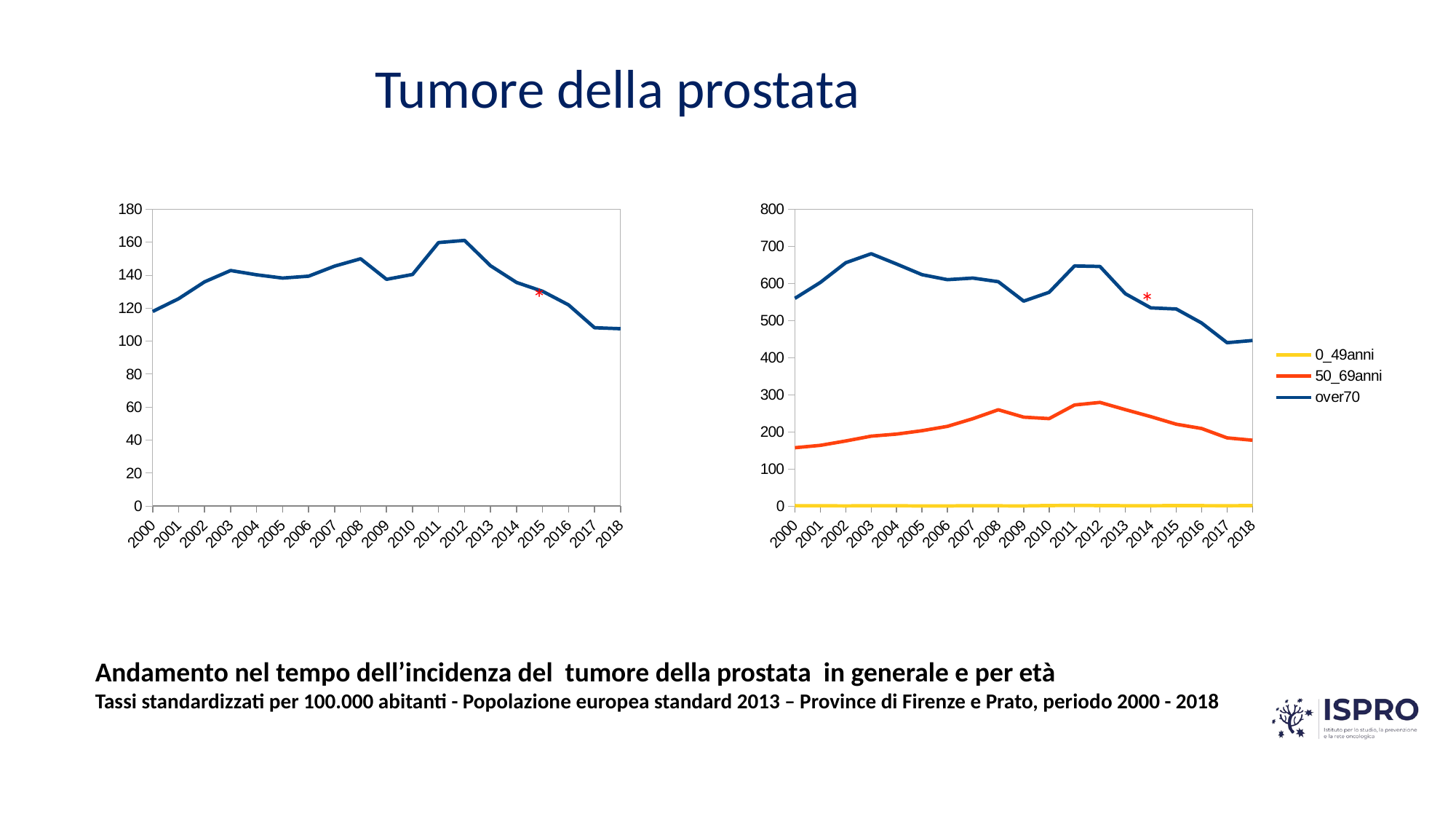
In the right-hand chart, which year has the highest value for the over70 series? 2003 In the left-hand chart, is the value for 2018 greater or less than 120? less What kind of chart is the chart on the left of the slide? line chart How many series does the legend of the right-hand chart list? 3 In the right-hand chart, which series has the larger value in 2010, over70 or 50_69anni? over70 In the left-hand chart, at which year is the red asterisk placed? 2015 In the right-hand chart, is the 50_69anni value for 2018 greater or less than 200? less In the left-hand chart, is the value for 2012 greater or less than 140? greater In the right-hand chart, which series is drawn in yellow? 0_49anni In the left-hand chart, do the values rise or fall from 2012 to 2018? fall How many years are plotted along the x axis of the left-hand chart? 19